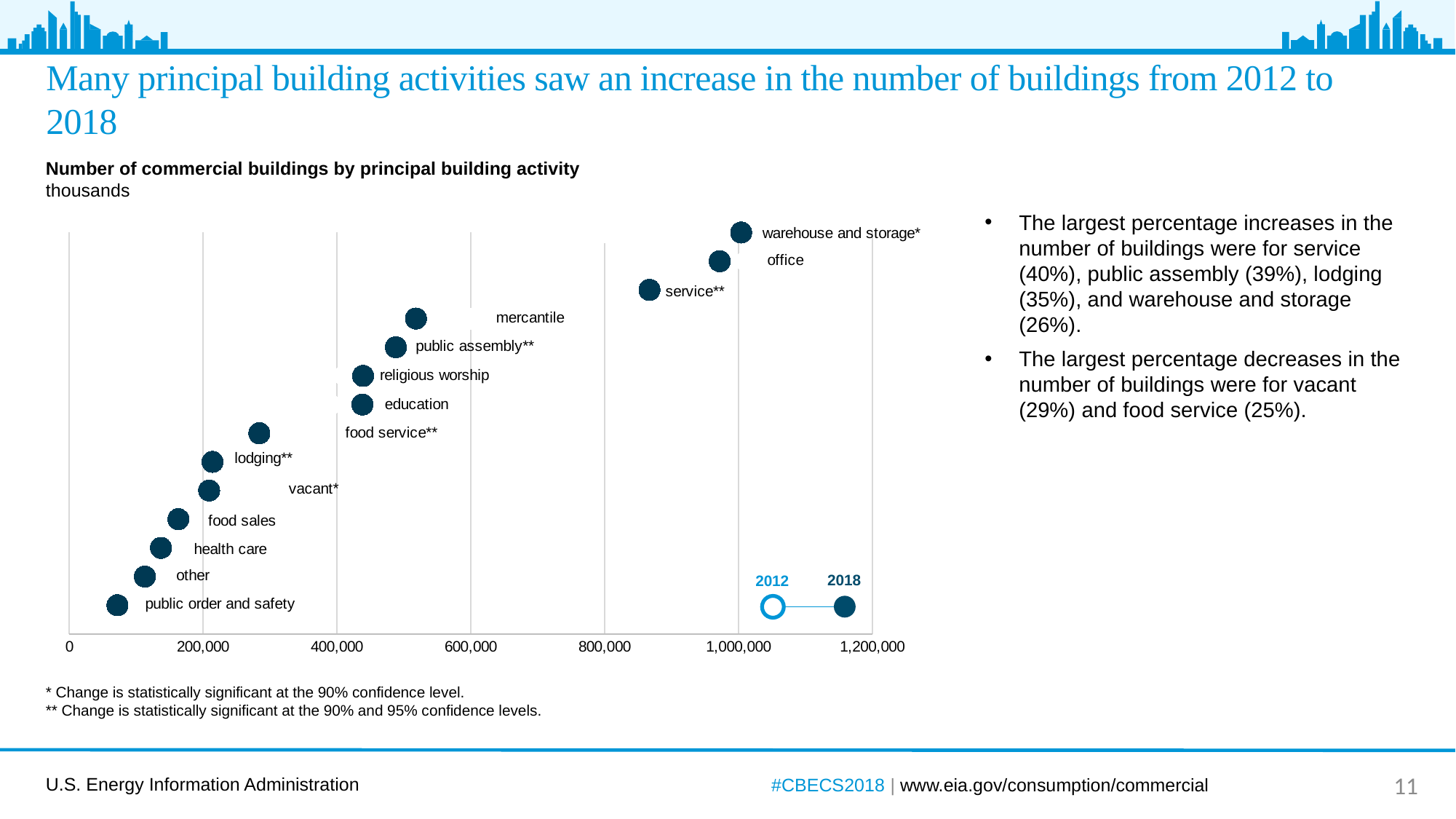
How many building activity categories are plotted on the chart? 14 Is the value for service** greater or less than 800,000? greater How many series does the chart's legend list? 2 Is the value for mercantile greater or less than 400,000? greater Which building activity has the lowest number of buildings on the chart? public order and safety What is the title of the chart? Number of commercial buildings by principal building activity Which building activity has the highest number of buildings on the chart? warehouse and storage* Which has more buildings, food service** or food sales? food service** Is the value for health care greater or less than 200,000? less Which has more buildings, service** or mercantile? service** Which years are shown in the chart's legend? 2012 and 2018